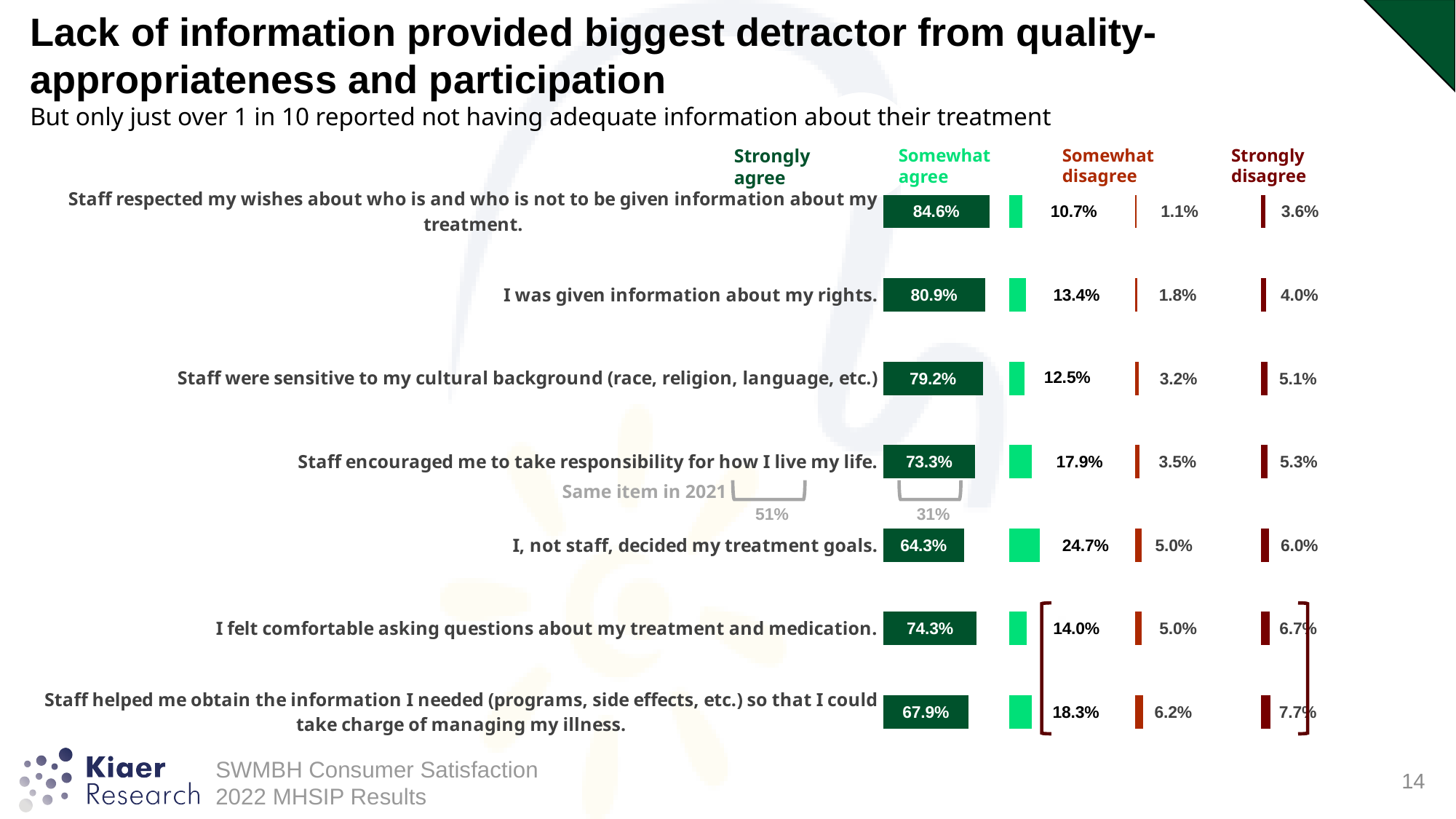
How many statements are shown in the chart? 7 Which statement has the highest Strongly disagree value? Staff helped me obtain the information I needed (programs, side effects, etc.) so that I could take charge of managing my illness. What is the Somewhat disagree value for "I, not staff, decided my treatment goals."? 5.0% How many response categories (series) does the chart show? 4 What is the difference in Strongly agree values between "Staff respected my wishes about who is and who is not to be given information about my treatment." and "I was given information about my rights."? 3.7 percentage points Which statement has the highest Strongly agree value? Staff respected my wishes about who is and who is not to be given information about my treatment. What kind of chart is shown on the slide? Bar chart Which has the larger Somewhat agree value: "I, not staff, decided my treatment goals." or "Staff encouraged me to take responsibility for how I live my life."? I, not staff, decided my treatment goals. What is the Strongly disagree value for "Staff helped me obtain the information I needed (programs, side effects, etc.) so that I could take charge of managing my illness."? 7.7% Which statement has the lowest Strongly agree value? I, not staff, decided my treatment goals. What is the Somewhat agree value for "I felt comfortable asking questions about my treatment and medication."? 14.0% What is the Strongly agree value for "I was given information about my rights."? 80.9%